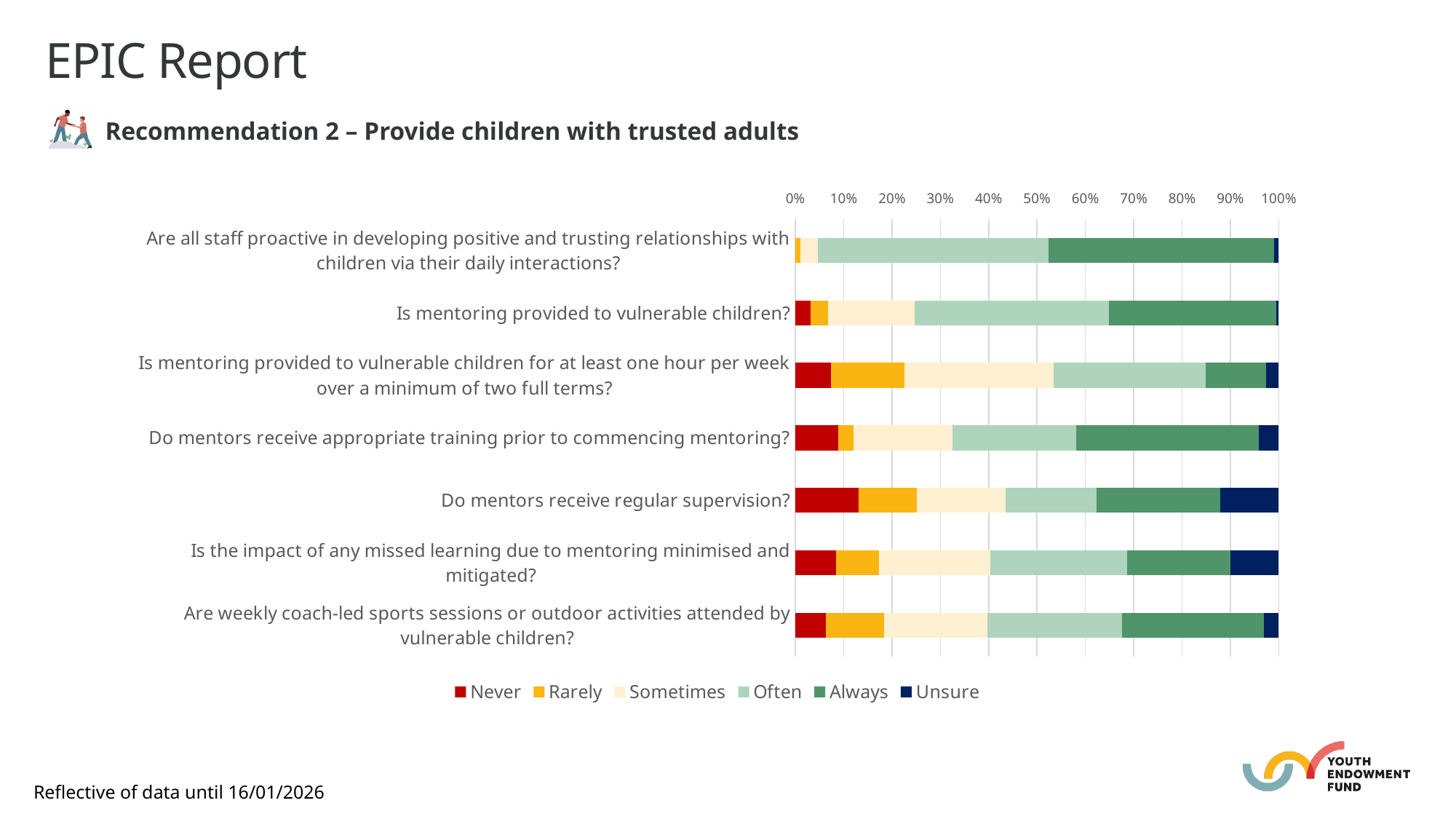
Is the 'Unsure' share for 'Do mentors receive regular supervision?' greater or less than 20%? less What are the legend entries of the chart, in order? Never, Rarely, Sometimes, Often, Always, Unsure Is the 'Always' share for 'Are all staff proactive in developing positive and trusting relationships with children via their daily interactions?' greater or less than 40%? greater How many series does the legend list? 6 Which colour represents the 'Never' series in the chart? Red What kind of chart is shown on the slide? Stacked bar chart Which question has the largest 'Always' share? Are all staff proactive in developing positive and trusting relationships with children via their daily interactions? Which has the larger 'Never' share: 'Do mentors receive regular supervision?' or 'Is mentoring provided to vulnerable children?' Do mentors receive regular supervision? Which question has the largest 'Never' share? Do mentors receive regular supervision? How many questions (categories) are plotted on the chart? 7 Which question has the smallest 'Never' share? Are all staff proactive in developing positive and trusting relationships with children via their daily interactions? Is the 'Never' share for 'Do mentors receive regular supervision?' greater or less than 10%? greater